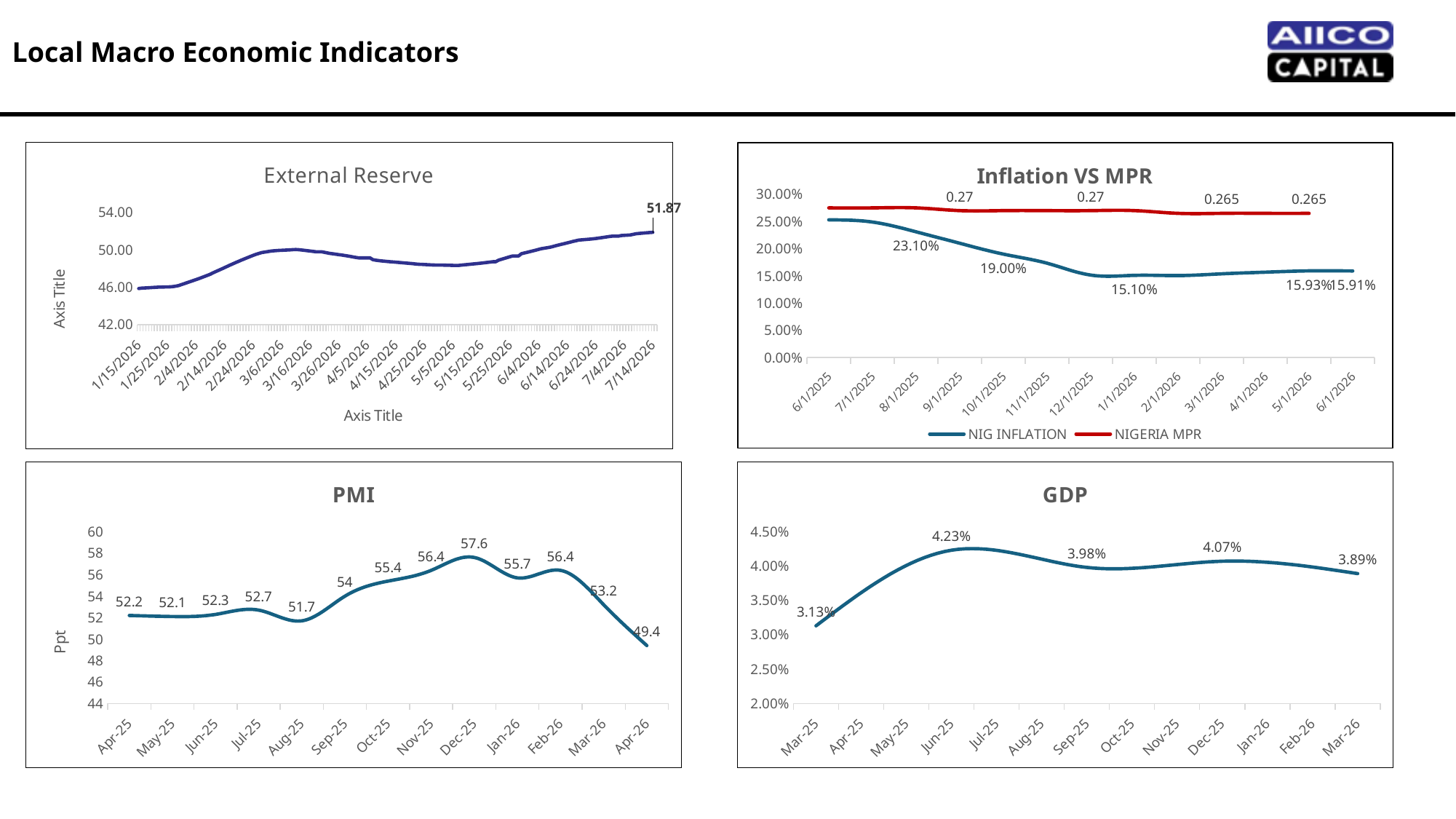
On the PMI chart, how many months are plotted? 13 On the PMI chart, what is the value for Dec-25? 57.6 On the GDP chart, which is larger, the Sep-25 value or the Dec-25 value? Dec-25 What kind of chart is the PMI chart? Line chart On the PMI chart, which month has the lowest value? Apr-26 On the GDP chart, what is the lowest labelled value? 3.13% On the Inflation VS MPR chart, how many series does the legend list? 2 On the External Reserve chart, what is the value labelled at the end of the line? 51.87 On the GDP chart, what is the value labelled for Jun-25? 4.23% On the PMI chart, which month has the highest value? Dec-25 On the Inflation VS MPR chart, what is the first labelled value for NIG INFLATION? 23.10% On the PMI chart, what is the difference between the Dec-25 value and the Apr-26 value? 8.2